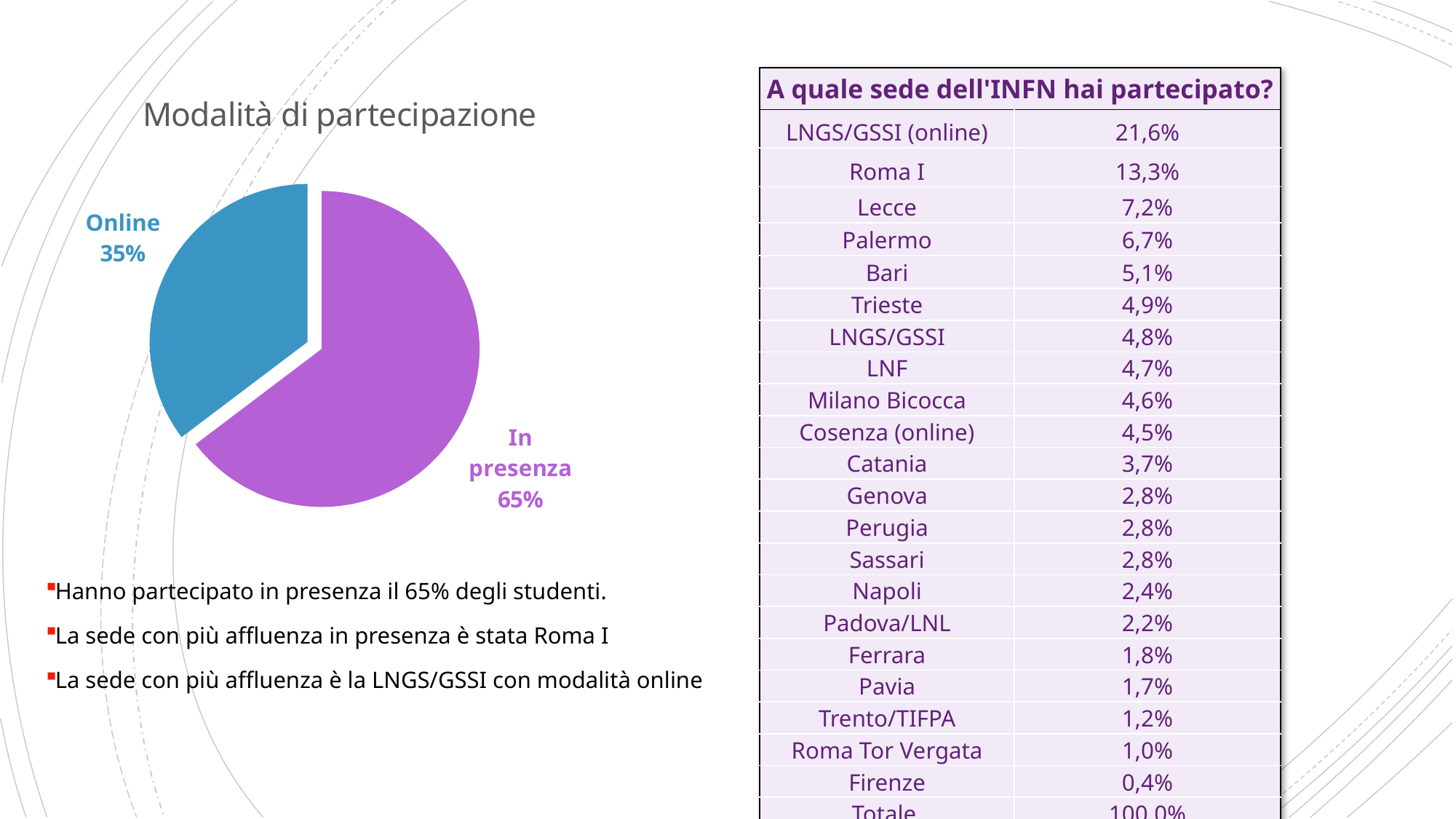
How many slices does the pie chart have? 2 What share of the pie does the "Online" slice represent? 35% What is the difference in percentage points between the "In presenza" and "Online" slices? 30 What is the total of the two slices shown in the pie chart? 100% Which slice of the pie chart is the smallest? Online What share of the pie does the "In presenza" slice represent? 65% What colour is the "Online" slice of the pie chart? blue What kind of chart is shown on the slide? pie chart Which is larger in the pie chart, "Online" or "In presenza"? In presenza What is the title of the pie chart? Modalità di partecipazione Which slice of the pie chart is the largest? In presenza